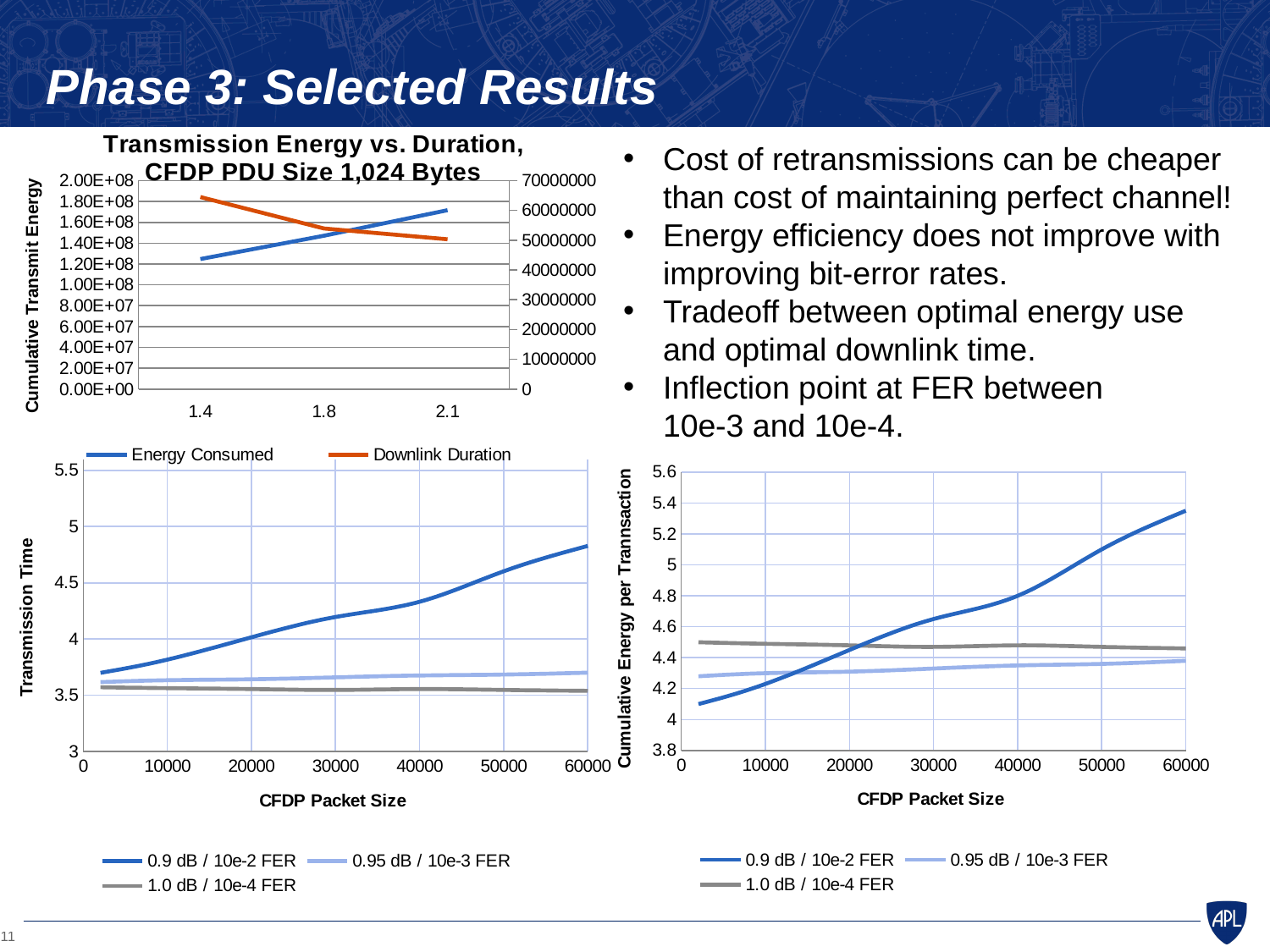
What kind of chart is the top-left chart titled 'Transmission Energy vs. Duration, CFDP PDU Size 1,024 Bytes'? line chart In the bottom-left chart with y axis 'Transmission Time', is the value of the 0.9 dB / 10e-2 FER series at 60000 greater or less than 4.5? greater In the bottom-left chart with y axis 'Transmission Time', which series has the highest value at a CFDP Packet Size of 60000? 0.9 dB / 10e-2 FER In the bottom-right chart with y axis 'Cumulative Energy per Trannsaction', does the 0.9 dB / 10e-2 FER series rise or fall as CFDP Packet Size increases? rise In the top-left chart 'Transmission Energy vs. Duration', how many series does the legend list? 2 In the top-left chart 'Transmission Energy vs. Duration', how many points are shown along the x axis? 3 In the bottom-right chart with y axis 'Cumulative Energy per Trannsaction', is the value of the 0.9 dB / 10e-2 FER series at 60000 greater or less than 5? greater In the top-left chart 'Transmission Energy vs. Duration', is the Downlink Duration value at 1.4 greater or less than 60000000? greater In the bottom-right chart with y axis 'Cumulative Energy per Trannsaction', which series has the lowest value at the smallest CFDP Packet Size? 0.9 dB / 10e-2 FER In the top-left chart 'Transmission Energy vs. Duration', does the Downlink Duration series rise or fall from 1.4 to 2.1? fall In the bottom-left chart with y axis 'Transmission Time', how many series does the legend list? 3